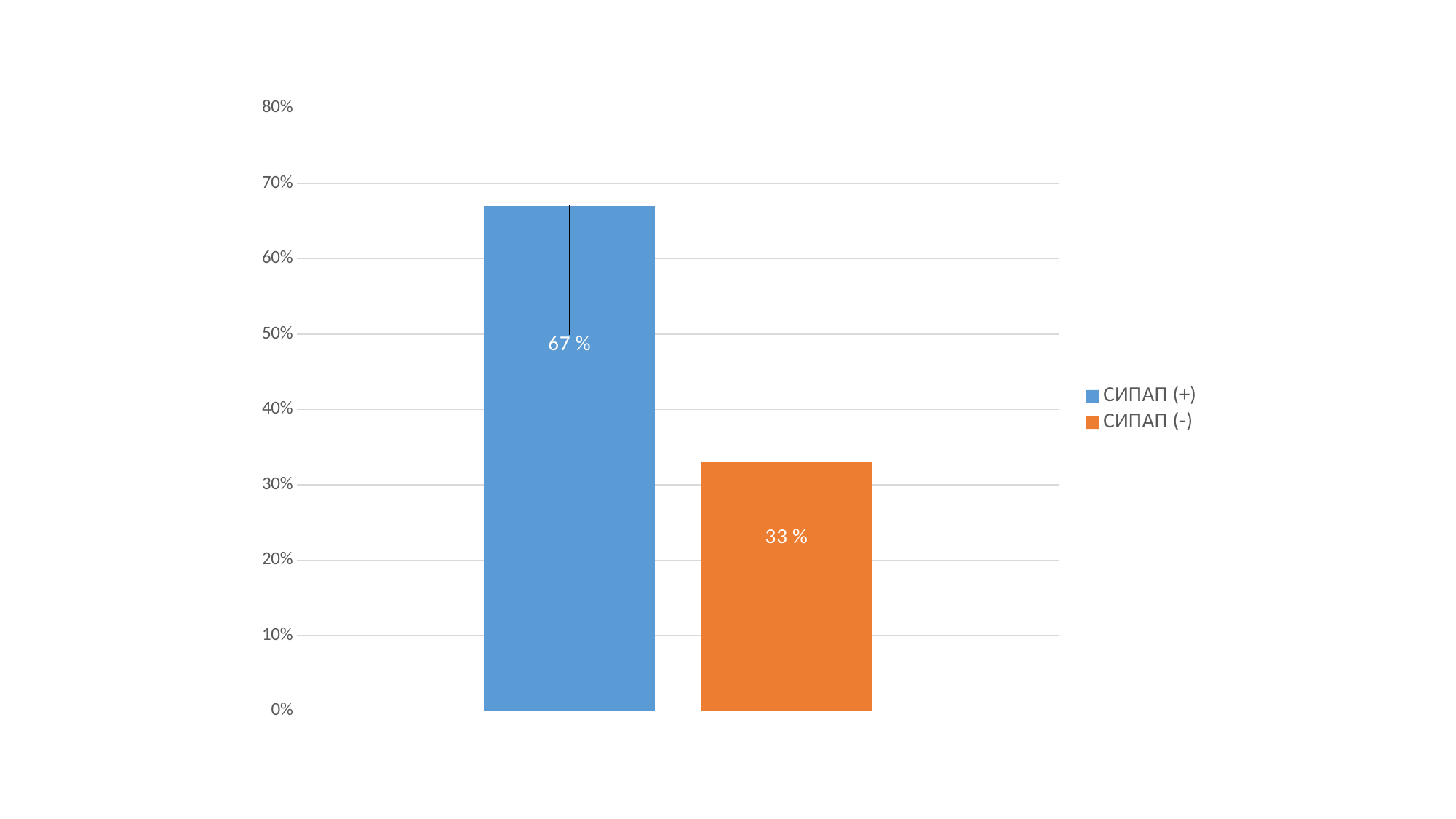
Is the value for СИПАП (+) greater or less than 60%? greater How many bars are plotted on the chart? 2 Which series has the lowest value? СИПАП (-) Which is larger, the value for СИПАП (+) or the value for СИПАП (-)? СИПАП (+) What is the value for СИПАП (+)? 67 % What kind of chart is shown on the slide? bar chart How many series does the legend list? 2 What colour is the bar for СИПАП (-)? orange Is the value for СИПАП (-) greater or less than 40%? less Which series has the highest value? СИПАП (+) What is the difference between the values for СИПАП (+) and СИПАП (-)? 34 % What is the value for СИПАП (-)? 33 %